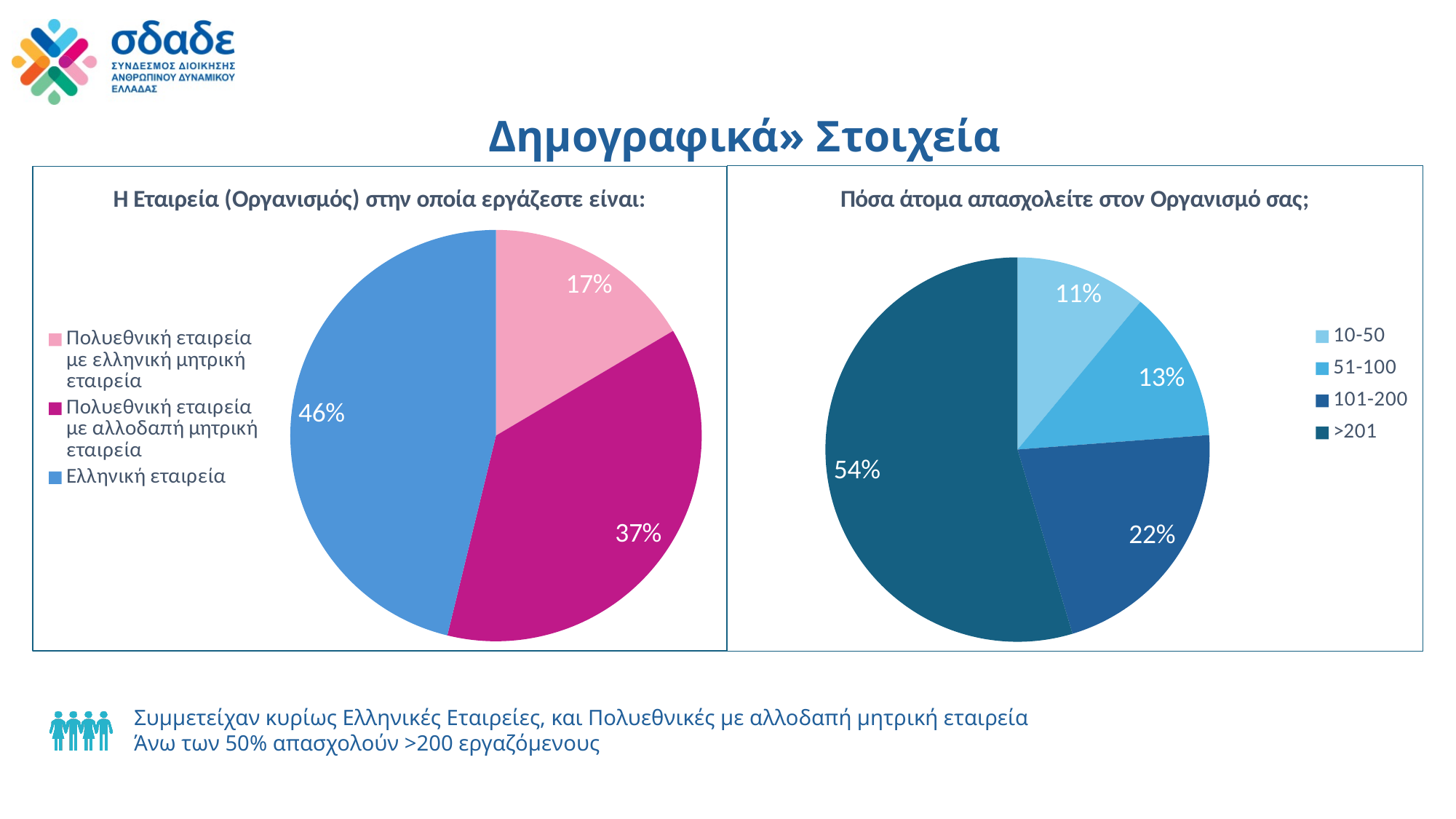
In the left chart (Η Εταιρεία (Οργανισμός) στην οποία εργάζεστε είναι:), what share is labelled for Πολυεθνική εταιρεία με ελληνική μητρική εταιρεία? 17% In the right chart (Πόσα άτομα απασχολείτε στον Οργανισμό σας;), what share is labelled for >201? 54% In the left chart (Η Εταιρεία (Οργανισμός) στην οποία εργάζεστε είναι:), how many categories does the legend list? 3 In the left chart (Η Εταιρεία (Οργανισμός) στην οποία εργάζεστε είναι:), what share is labelled for Ελληνική εταιρεία? 46% In the left chart (Η Εταιρεία (Οργανισμός) στην οποία εργάζεστε είναι:), which category has the largest slice? Ελληνική εταιρεία In the left chart (Η Εταιρεία (Οργανισμός) στην οποία εργάζεστε είναι:), which category has the smallest slice? Πολυεθνική εταιρεία με ελληνική μητρική εταιρεία In the right chart (Πόσα άτομα απασχολείτε στον Οργανισμό σας;), which category has the smallest slice? 10-50 In the right chart (Πόσα άτομα απασχολείτε στον Οργανισμό σας;), what share is labelled for 101-200? 22% In the left chart (Η Εταιρεία (Οργανισμός) στην οποία εργάζεστε είναι:), what is the difference in percentage points between Ελληνική εταιρεία and Πολυεθνική εταιρεία με αλλοδαπή μητρική εταιρεία? 9 percentage points In the right chart (Πόσα άτομα απασχολείτε στον Οργανισμό σας;), which is larger, the slice for 51-100 or the slice for 101-200? 101-200 In the right chart (Πόσα άτομα απασχολείτε στον Οργανισμό σας;), how many categories does the legend list? 4 What type of chart is the right chart (Πόσα άτομα απασχολείτε στον Οργανισμό σας;)? Pie chart